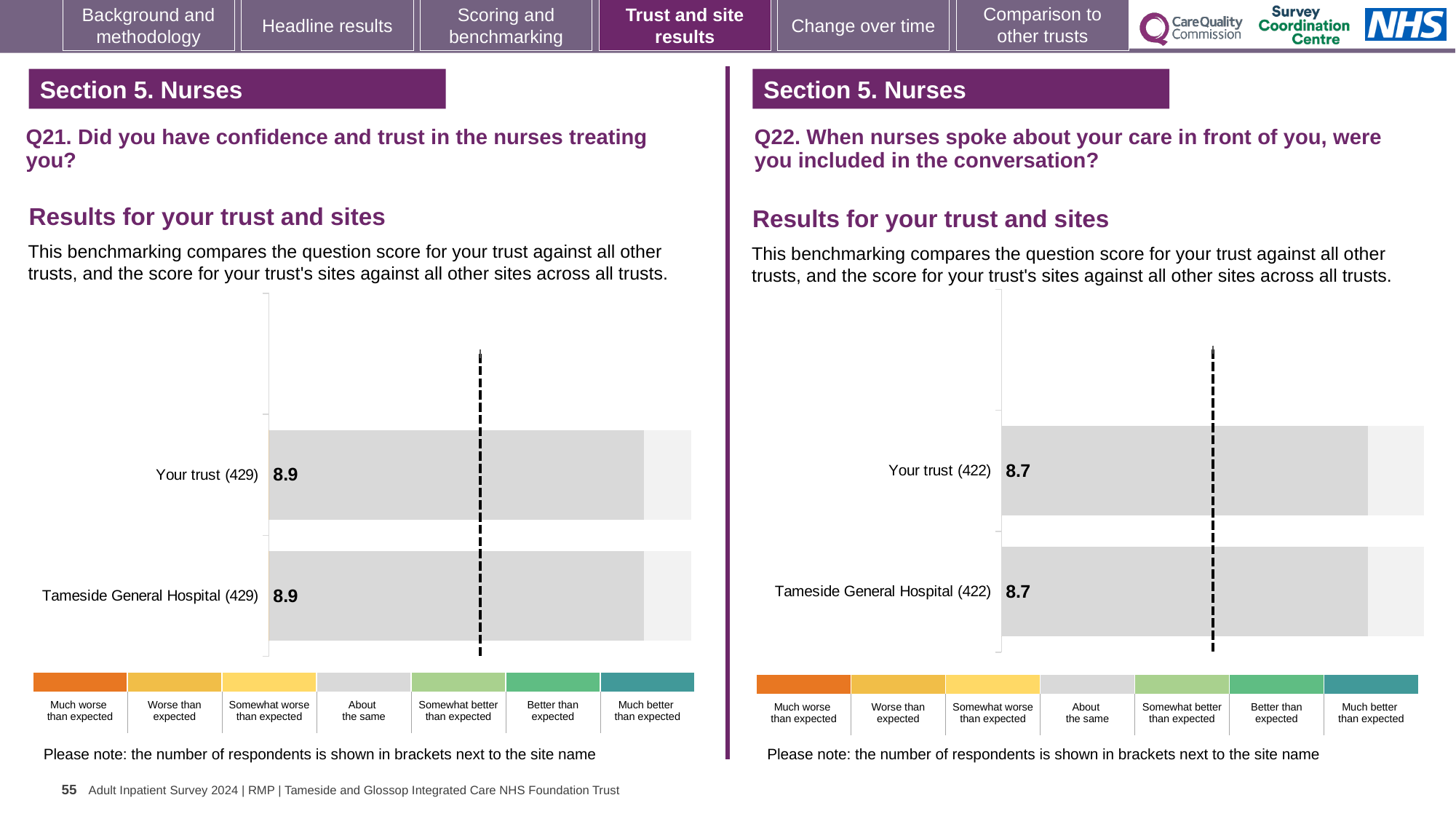
In the Q21 chart on the left, what is the score for Tameside General Hospital? 8.9 In the Q21 chart on the left, what is the score for Your trust? 8.9 In the Q22 chart on the right, what is the score for Tameside General Hospital? 8.7 In the Q22 chart on the right, what is the score for Your trust? 8.7 In the colour key below the Q22 chart on the right, which category is shown in orange? Much worse than expected What is the difference between the Your trust score in the Q21 chart on the left and the Your trust score in the Q22 chart on the right? 0.2 How many categories does the colour key below the Q21 chart on the left list? 7 Which is larger: the Your trust score in the Q21 chart on the left or the Your trust score in the Q22 chart on the right? Q21 chart (8.9) In the Q22 chart on the right, how many respondents are shown in brackets for Tameside General Hospital? 422 How many bars are plotted in the Q21 chart on the left? 2 In the Q21 chart on the left, how many respondents are shown in brackets for Your trust? 429 What kind of chart is the Q22 chart on the right? Bar chart